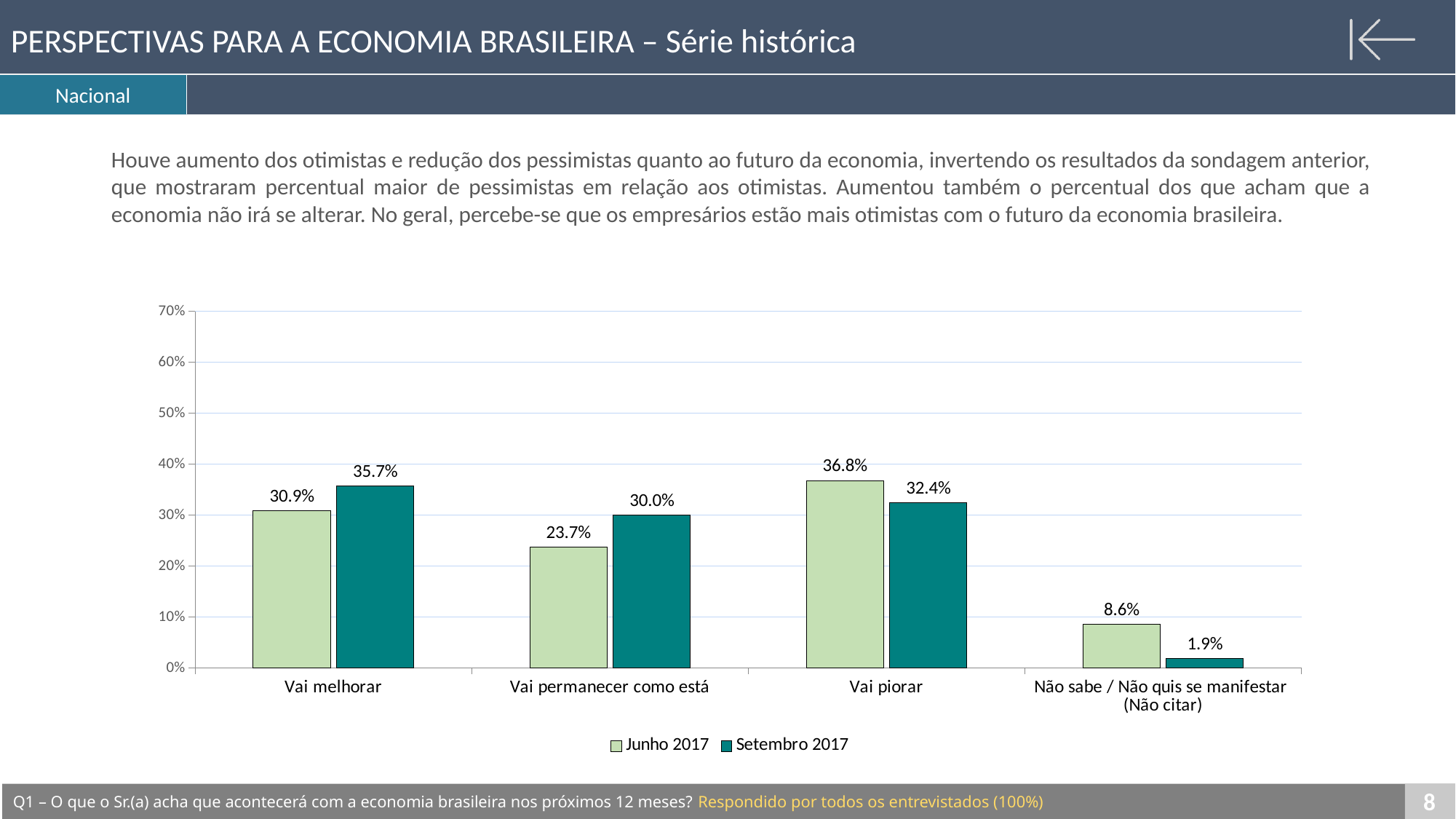
Which series is shown in the darker teal colour? Setembro 2017 What is the value for "Não sabe / Não quis se manifestar (Não citar)" in the Setembro 2017 series? 1.9% What is the value for "Vai melhorar" in the Setembro 2017 series? 35.7% What is the value for "Vai piorar" in the Junho 2017 series? 36.8% How many series does the legend list? 2 Is the Junho 2017 value for "Vai melhorar" greater or less than 40%? less Which category has the highest value in the Junho 2017 series? Vai piorar For "Vai piorar", which series has the larger value, Junho 2017 or Setembro 2017? Junho 2017 What kind of chart is shown on the slide? Bar chart What is the difference between the Setembro 2017 and Junho 2017 values for "Vai permanecer como está"? 6.3 percentage points How many categories are shown on the x axis? 4 Which category has the lowest value in the Setembro 2017 series? Não sabe / Não quis se manifestar (Não citar)